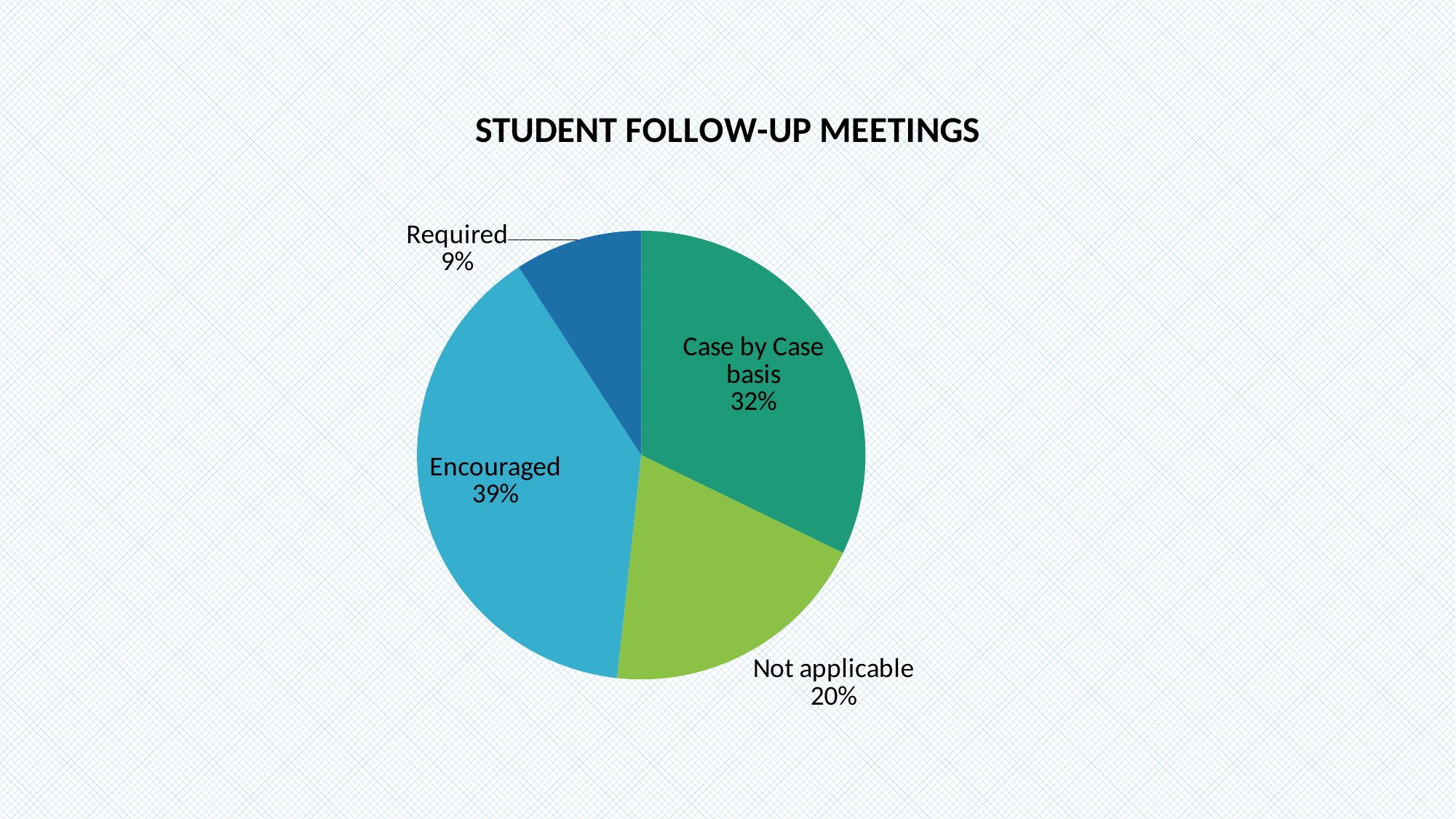
What is the title of the chart? STUDENT FOLLOW-UP MEETINGS What is the difference in percentage points between Encouraged and Case by Case basis? 7 What share of the pie is labelled Case by Case basis? 32% What colour is the Not applicable slice? green How many slices does the pie chart have? 4 What share of the pie is labelled Not applicable? 20% Which category has the largest slice of the pie? Encouraged Which category has the smallest slice of the pie? Required What type of chart is shown on the slide? pie chart What share of the pie is labelled Encouraged? 39% Which is larger, the Not applicable slice or the Required slice? Not applicable